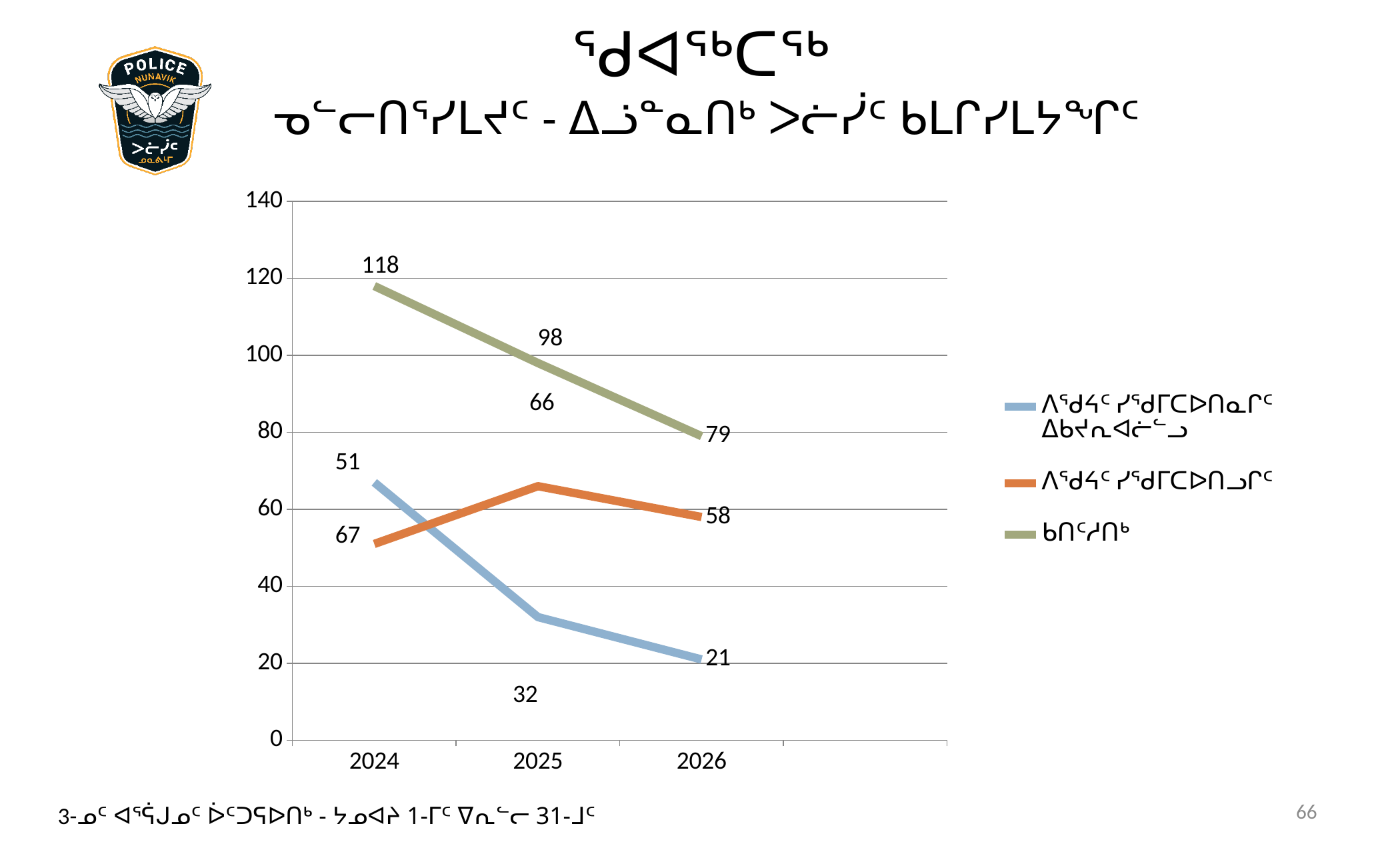
What kind of chart is shown on the slide? line chart How many series does the legend list? 3 What is the value of the green line (ᑲᑎᑦᓱᑎᒃ) in 2024? 118 In which year is the green line (ᑲᑎᑦᓱᑎᒃ) highest? 2024 How many years are shown on the x axis? 3 By how much did the green line (ᑲᑎᑦᓱᑎᒃ) decrease from 2024 to 2026? 39 What is the value of the orange line (ᐱᖁᔭᑦ ᓯᖁᒥᑕᐅᑎᓗᒋᑦ) in 2025? 66 In 2026, which is larger: the orange line or the blue line? orange line What is the value of the blue line in 2026? 21 What is the value of the green line (ᑲᑎᑦᓱᑎᒃ) in 2026? 79 Is the value of the blue line in 2025 greater or less than 40? less Does the green line (ᑲᑎᑦᓱᑎᒃ) rise or fall from 2024 to 2026? fall